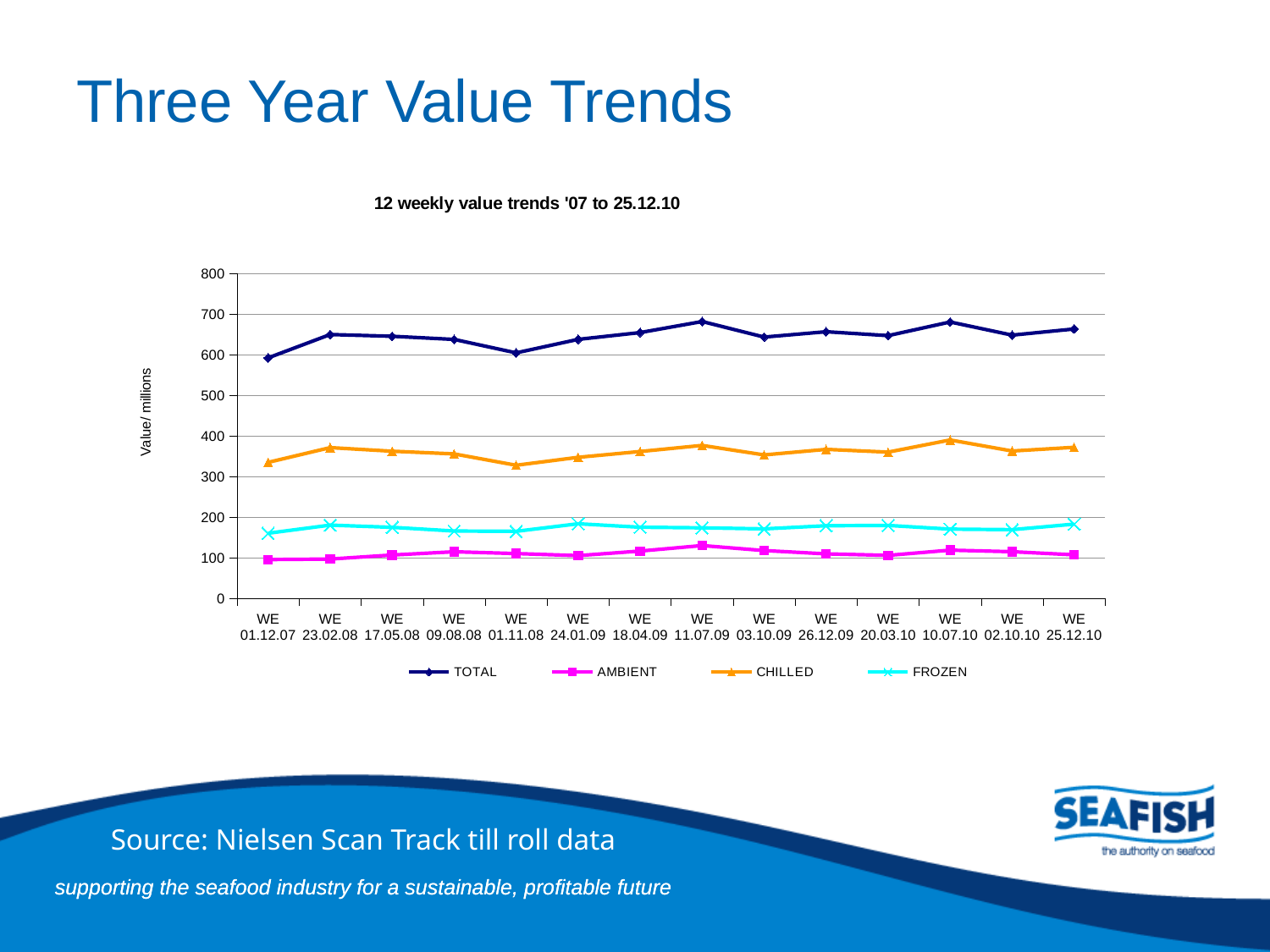
At WE 10.07.10, which is larger, CHILLED or FROZEN? CHILLED Is the TOTAL value for WE 11.07.09 greater or less than 700? less Which series has the highest values across the chart? TOTAL Which series has the lowest values across the chart? AMBIENT How many series does the legend list? 4 What is the title of the chart? 12 weekly value trends '07 to 25.12.10 Is the CHILLED value for WE 01.11.08 greater or less than 400? less Is the AMBIENT value for WE 11.07.09 greater or less than 100? greater Does the TOTAL value rise or fall from WE 01.12.07 to WE 23.02.08? rise What kind of chart is shown on the slide? Line chart What is the label on the y axis? Value/ millions How many weekly points are plotted along the x axis? 14